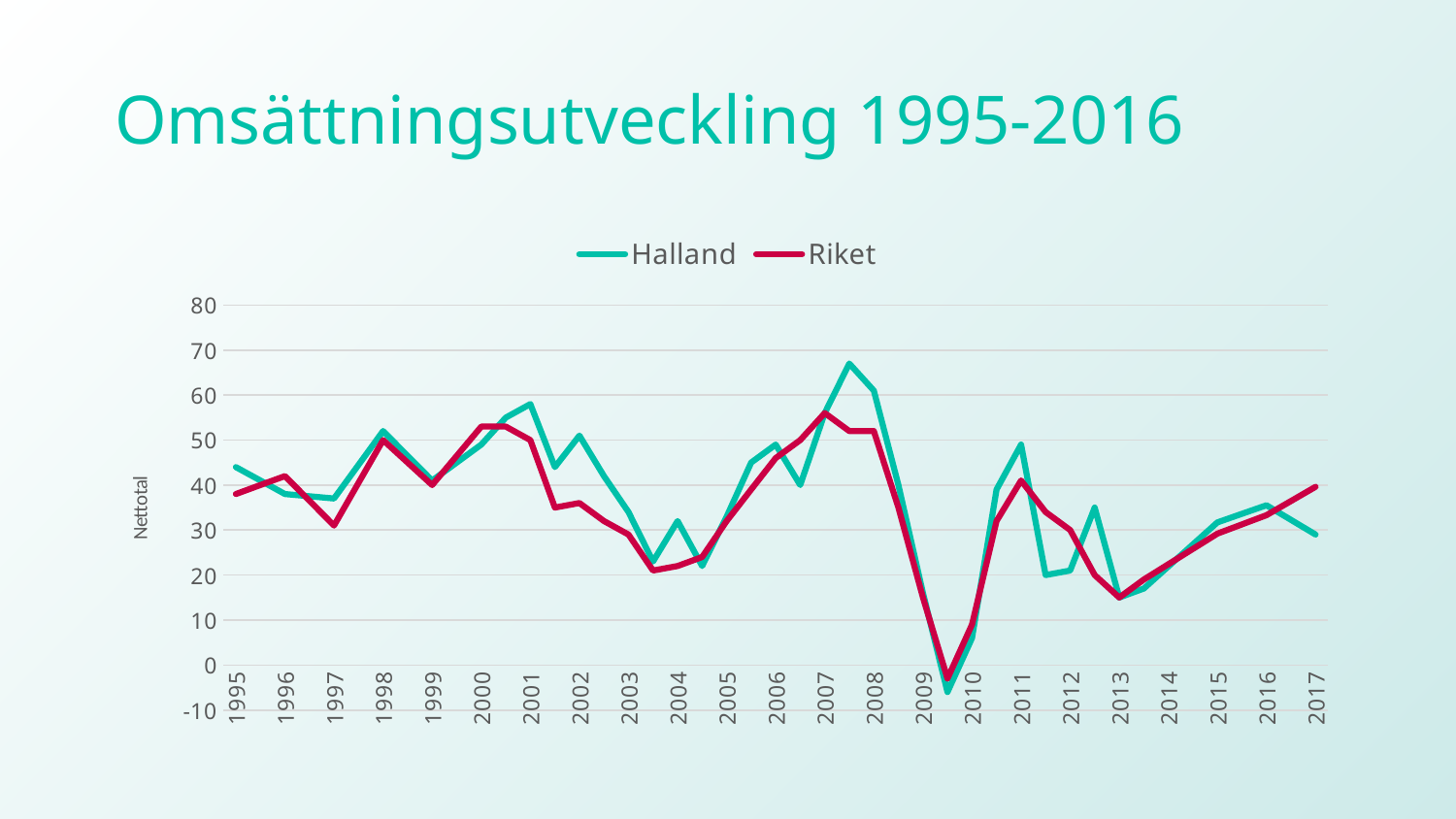
Which series has the higher value in 2017, Halland or Riket? Riket Which series has the higher value in 2008, Halland or Riket? Halland What is the title of the chart? Omsättningsutveckling 1995-2016 Is the value for Riket in 2004 greater or less than 30? less How many series does the legend list? 2 Is the value for Riket in 2017 greater or less than 30? greater What kind of chart is shown on the slide? line chart What are the two series named in the legend? Halland and Riket How many years are labelled on the x axis? 23 Is the value for Halland in 1995 greater or less than 40? greater